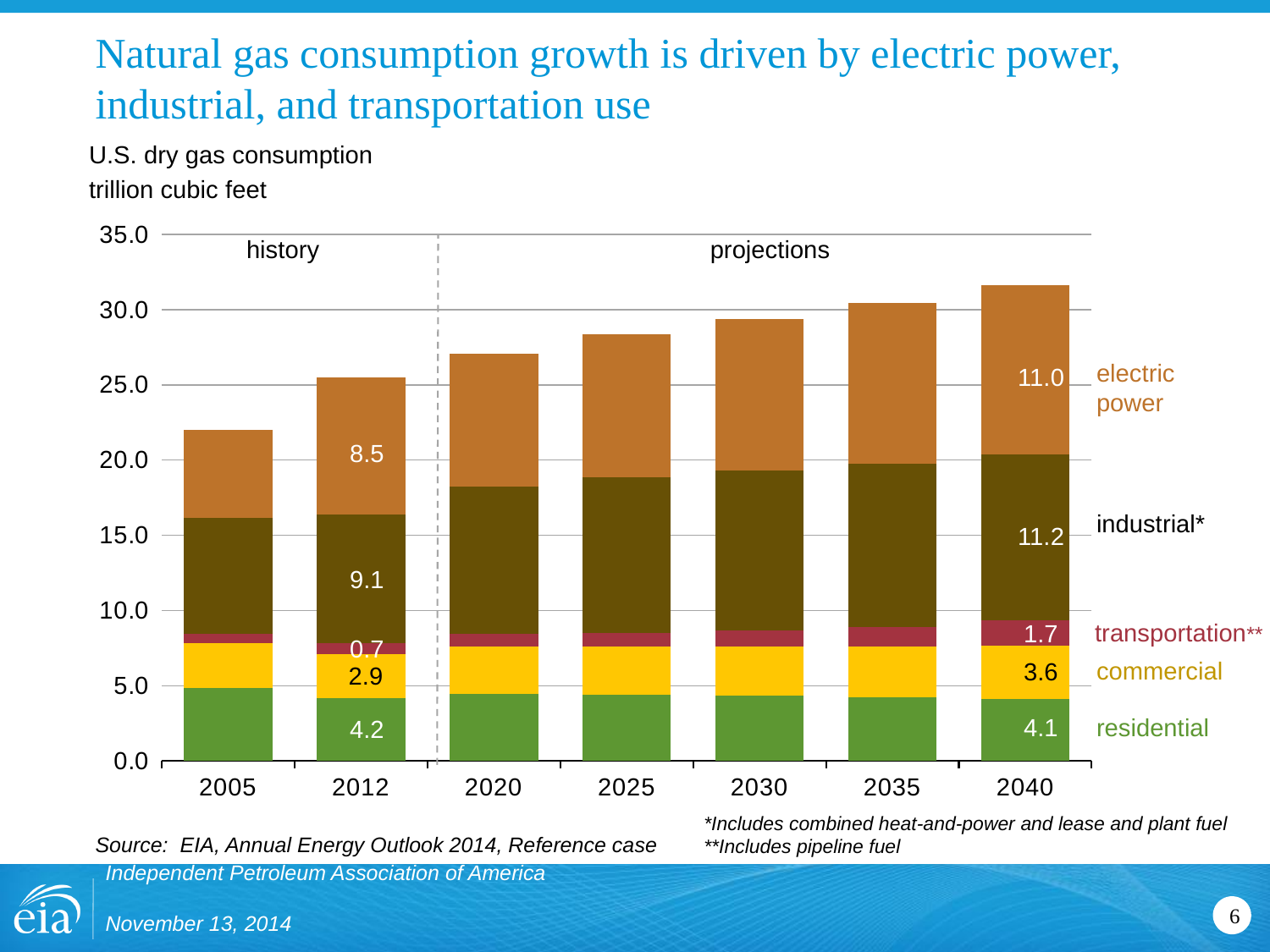
What is the total of the stacked bar for 2040? 31.6 What is the residential value for 2012? 4.2 What is the industrial* value for 2040? 11.2 Is the total for 2005 greater or less than 20.0? greater How many years are shown on the x axis? 7 What is the total of the stacked bar for 2012? 25.4 How many series (sectors) are stacked in each bar? 5 In 2040, which is larger: the industrial* value or the electric power value? industrial* What is the electric power value for 2012? 8.5 By how much does the electric power value in 2040 exceed the electric power value in 2012? 2.5 Which year has the highest total dry gas consumption? 2040 What is the transportation** value for 2040? 1.7